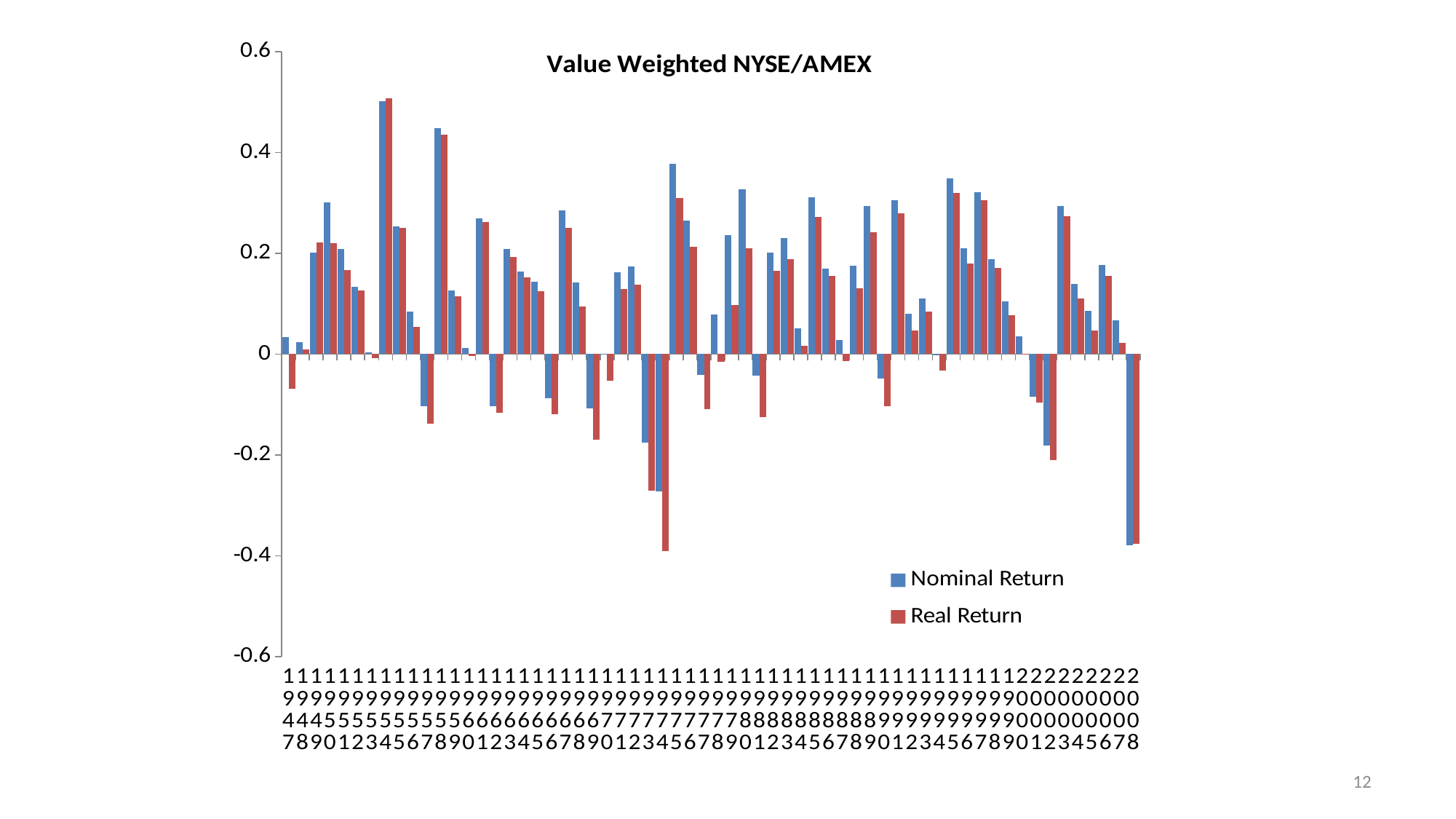
What kind of chart is shown on the slide? bar chart Is the Nominal Return for 1954 greater or less than 0.4? greater Which year has the lowest Nominal Return? 2008 How many years are plotted along the x axis? 62 Which is larger, the Nominal Return for 1975 or for 1985? 1975 Which year has the highest Real Return? 1954 Is the Real Return for 1974 greater or less than -0.2? less How many series does the legend list? 2 Which series is shown in red? Real Return What is the title of the chart? Value Weighted NYSE/AMEX Which year has the highest Nominal Return? 1954 Is the Nominal Return for 1975 greater or less than 0.2? greater